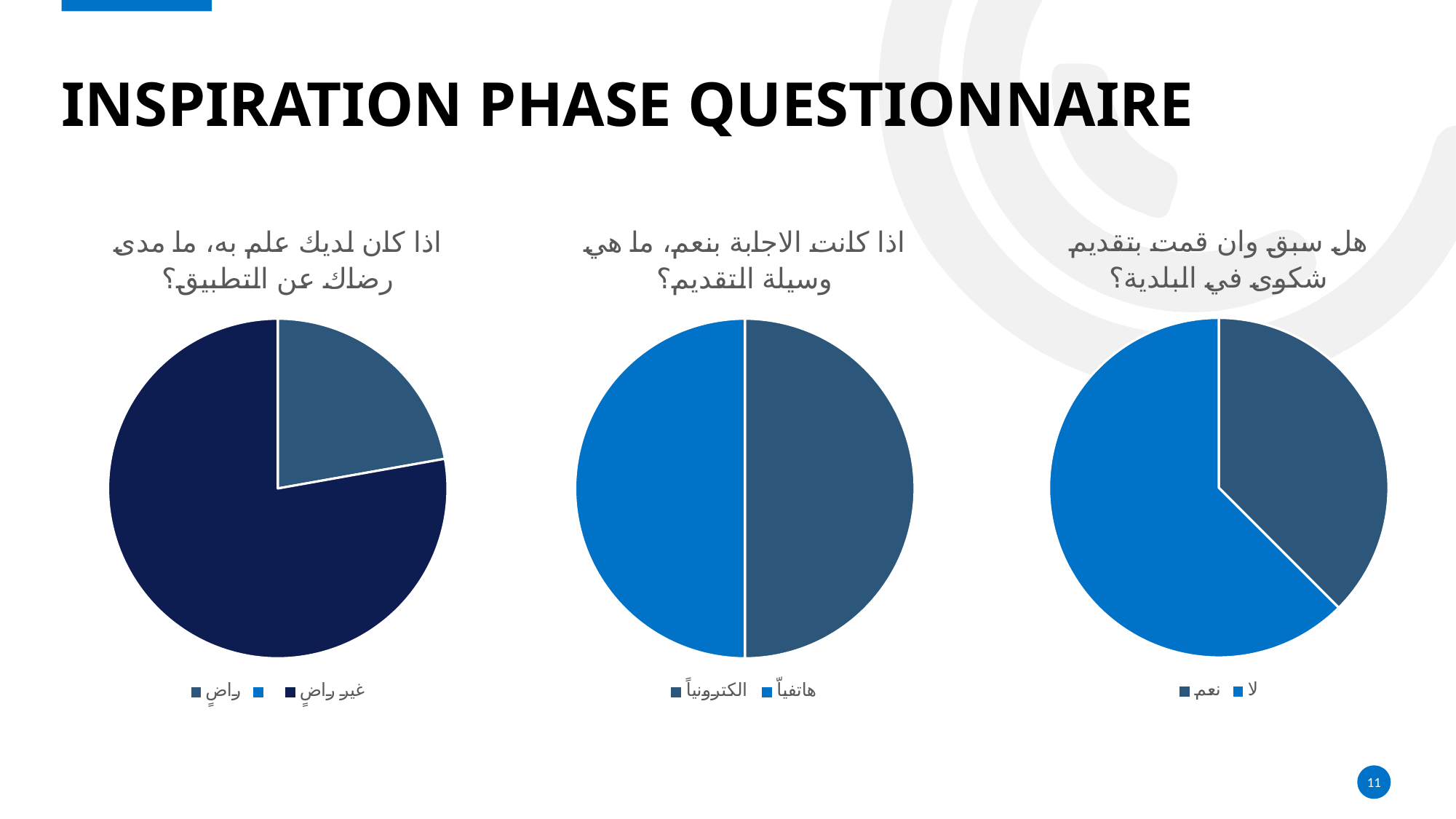
What kind of chart is the right-hand chart titled "هل سبق وان قمت بتقديم شكوى في البلدية؟"? Pie chart In the right-hand chart titled "هل سبق وان قمت بتقديم شكوى في البلدية؟", which category has the smallest slice? نعم How many entries does the legend of the middle chart titled "اذا كانت الاجابة بنعم، ما هي وسيلة التقديم؟" list? 2 How many slices are visible in the middle chart titled "اذا كانت الاجابة بنعم، ما هي وسيلة التقديم؟"? 2 In the right-hand chart titled "هل سبق وان قمت بتقديم شكوى في البلدية؟", which category has the largest slice? لا In the left-hand chart titled "اذا كان لديك علم به، ما مدى رضاك عن التطبيق؟", which category has the largest slice? غير راضٍ What kind of chart is the left-hand chart titled "اذا كان لديك علم به، ما مدى رضاك عن التطبيق؟"? Pie chart In the right-hand chart titled "هل سبق وان قمت بتقديم شكوى في البلدية؟", which slice is larger, نعم or لا? لا How many pie charts are shown on the slide? 3 In the left-hand chart titled "اذا كان لديك علم به، ما مدى رضاك عن التطبيق؟", which slice is larger, راضٍ or غير راضٍ? غير راضٍ How many entries does the legend of the right-hand chart titled "هل سبق وان قمت بتقديم شكوى في البلدية؟" list? 2 In the middle chart titled "اذا كانت الاجابة بنعم، ما هي وسيلة التقديم؟", which legend entry is shown in the bright blue colour? هاتفياً